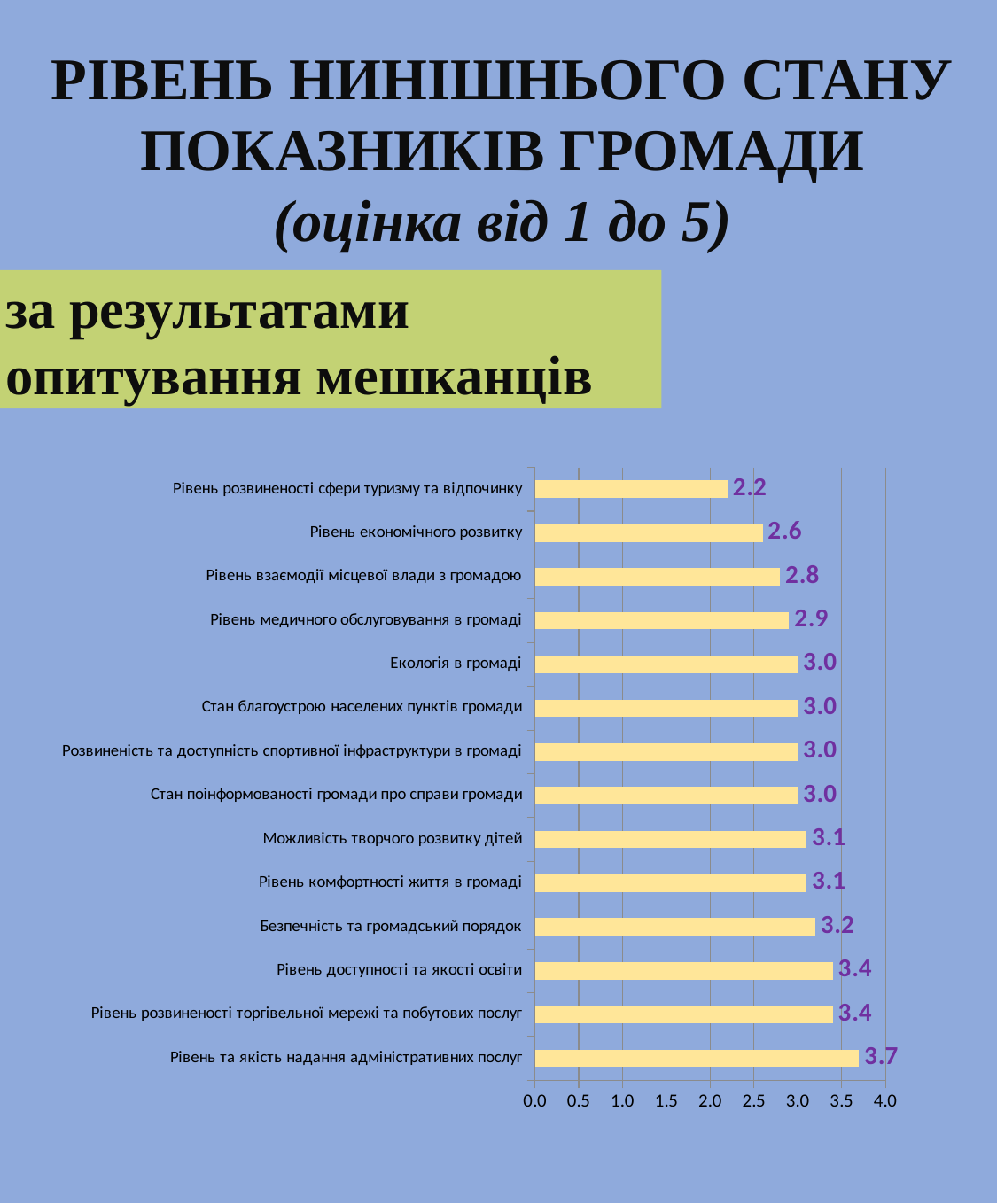
Which category has the lowest value? Рівень розвиненості сфери туризму та відпочинку How many categories are shown in the chart? 14 Which is larger: the value for «Рівень доступності та якості освіти» or the value for «Рівень взаємодії місцевої влади з громадою»? Рівень доступності та якості освіти What kind of chart is shown on the slide? bar chart What is the maximum value shown on the horizontal axis? 4.0 What value is shown for «Безпечність та громадський порядок»? 3.2 What value is shown for «Рівень розвиненості сфери туризму та відпочинку»? 2.2 Is the value for «Рівень економічного розвитку» greater or less than 3.0? less What value is shown for «Рівень економічного розвитку»? 2.6 What value is shown for «Рівень медичного обслуговування в громаді»? 2.9 What is the difference between the values for «Рівень та якість надання адміністративних послуг» and «Рівень розвиненості сфери туризму та відпочинку»? 1.5 Which category has the highest value? Рівень та якість надання адміністративних послуг